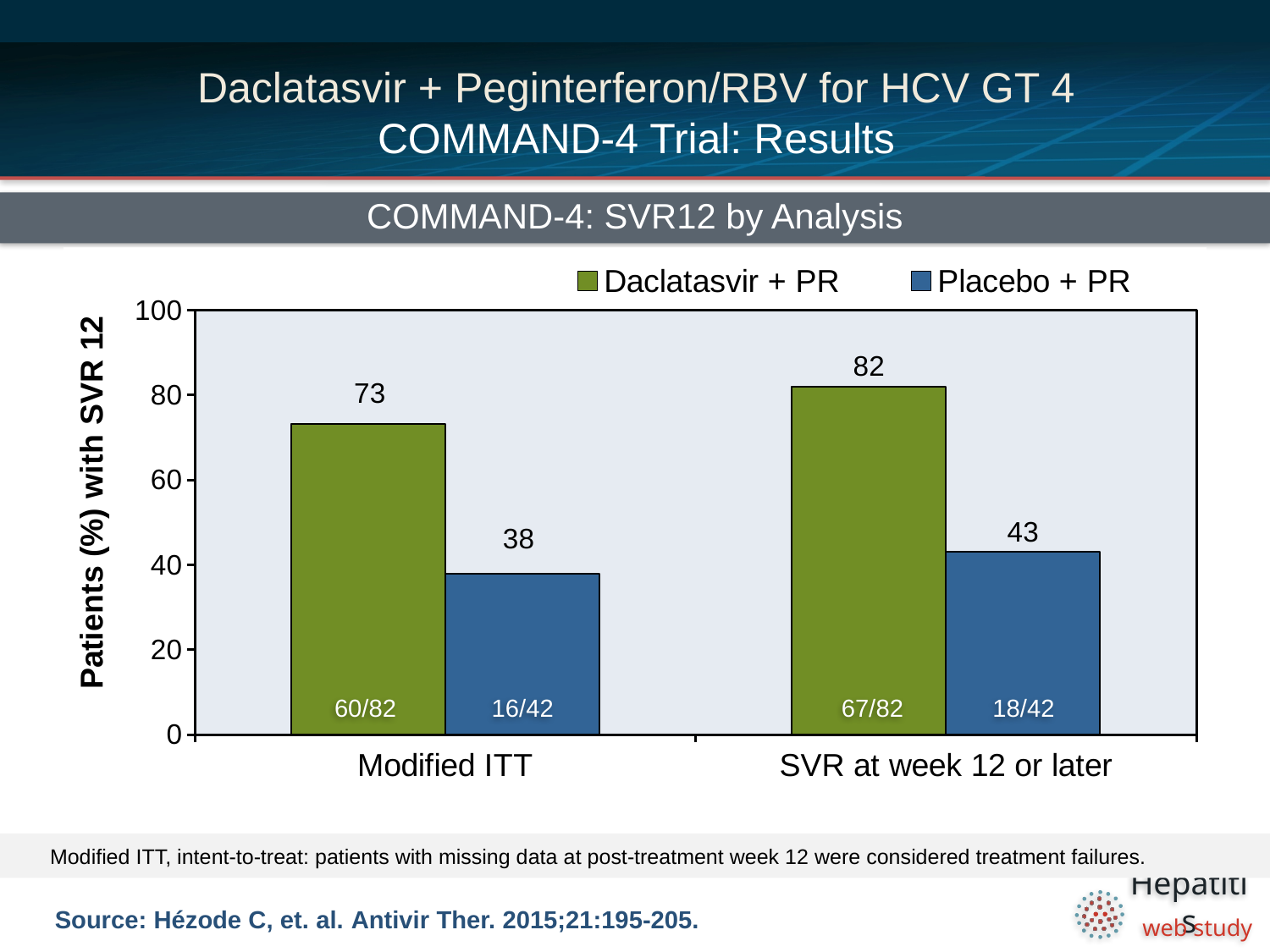
Which is larger: Daclatasvir + PR in Modified ITT or Daclatasvir + PR in SVR at week 12 or later? Daclatasvir + PR in SVR at week 12 or later What is the difference between Daclatasvir + PR and Placebo + PR in the SVR at week 12 or later analysis? 39 What is the fraction label shown inside the Placebo + PR bar for SVR at week 12 or later? 18/42 What kind of chart is shown? Bar chart Which bar has the highest value on the chart? Daclatasvir + PR, SVR at week 12 or later What is the value for Daclatasvir + PR in the Modified ITT analysis? 73 What is the value for Placebo + PR in the Modified ITT analysis? 38 Which bar has the lowest value on the chart? Placebo + PR, Modified ITT How many categories are shown on the x axis? 2 How many series does the legend list? 2 What is the difference between Daclatasvir + PR and Placebo + PR in the Modified ITT analysis? 35 What is the value for Placebo + PR in the SVR at week 12 or later analysis? 43